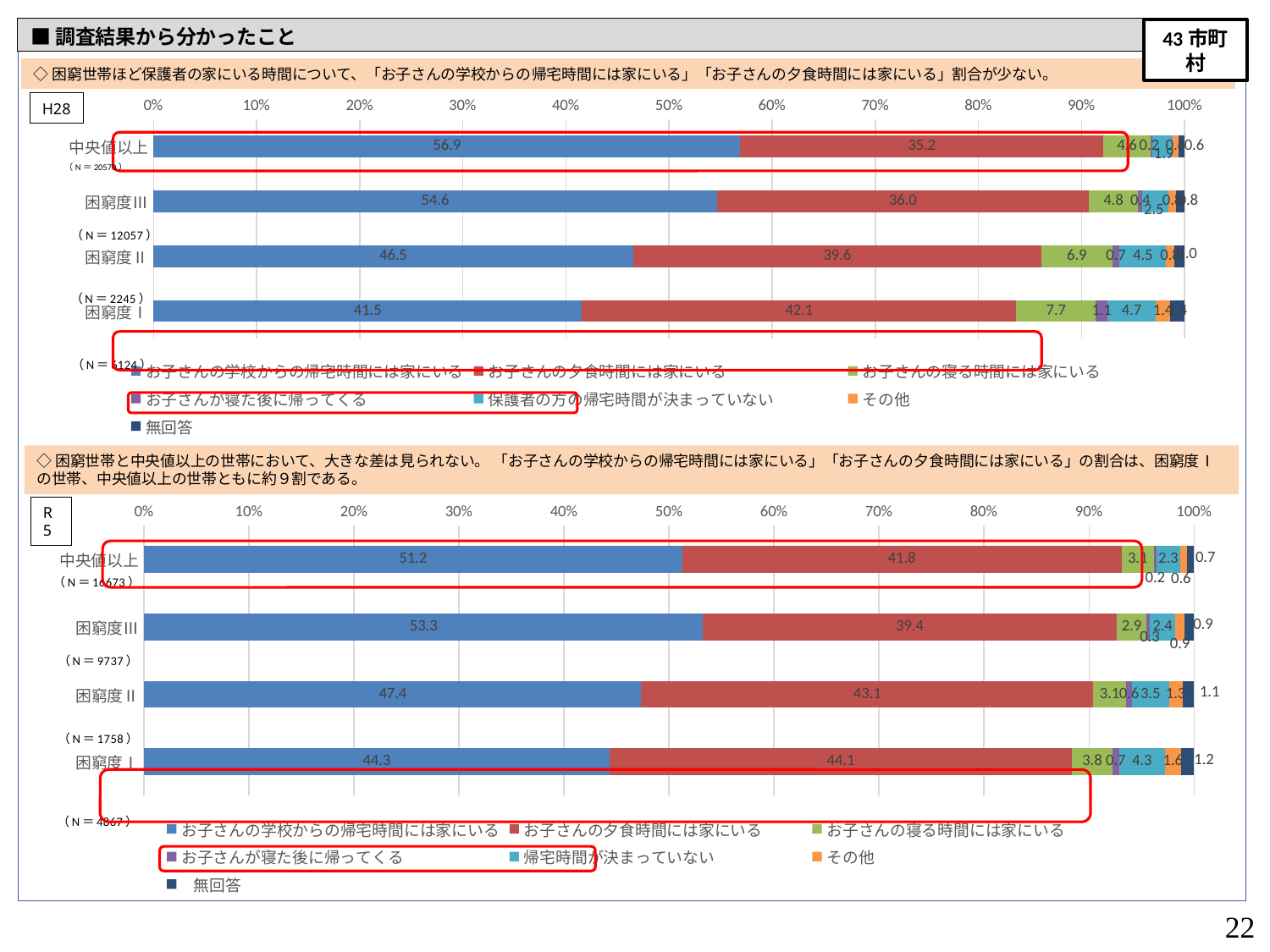
In the H28 chart (top), which category has the highest value for 「お子さんの学校からの帰宅時間には家にいる」? 中央値以上 How many categories are plotted in the R5 chart (bottom)? 4 In the R5 chart (bottom), which category has the highest value for 「お子さんの夕食時間には家にいる」? 困窮度Ⅰ In the R5 chart (bottom), what is the value of 「お子さんの夕食時間には家にいる」 for 困窮度Ⅱ? 43.1 In the H28 chart (top), what is the value of 「お子さんの夕食時間には家にいる」 for 困窮度Ⅰ? 42.1 What kind of chart is the R5 chart (bottom)? Stacked bar chart How many series does the legend of the H28 chart (top) list? 7 In the R5 chart (bottom), what is the value of 「お子さんの学校からの帰宅時間には家にいる」 for 困窮度Ⅲ? 53.3 In the H28 chart (top), what is the value of 「お子さんの学校からの帰宅時間には家にいる」 for 中央値以上? 56.9 In the H28 chart (top), which category has the lowest value for 「お子さんの学校からの帰宅時間には家にいる」? 困窮度Ⅰ In the H28 chart (top), what is the difference between the 「お子さんの学校からの帰宅時間には家にいる」 values for 中央値以上 and 困窮度Ⅰ? 15.4 In the R5 chart (bottom), which is larger for 中央値以上: 「お子さんの学校からの帰宅時間には家にいる」 or 「お子さんの夕食時間には家にいる」? お子さんの学校からの帰宅時間には家にいる